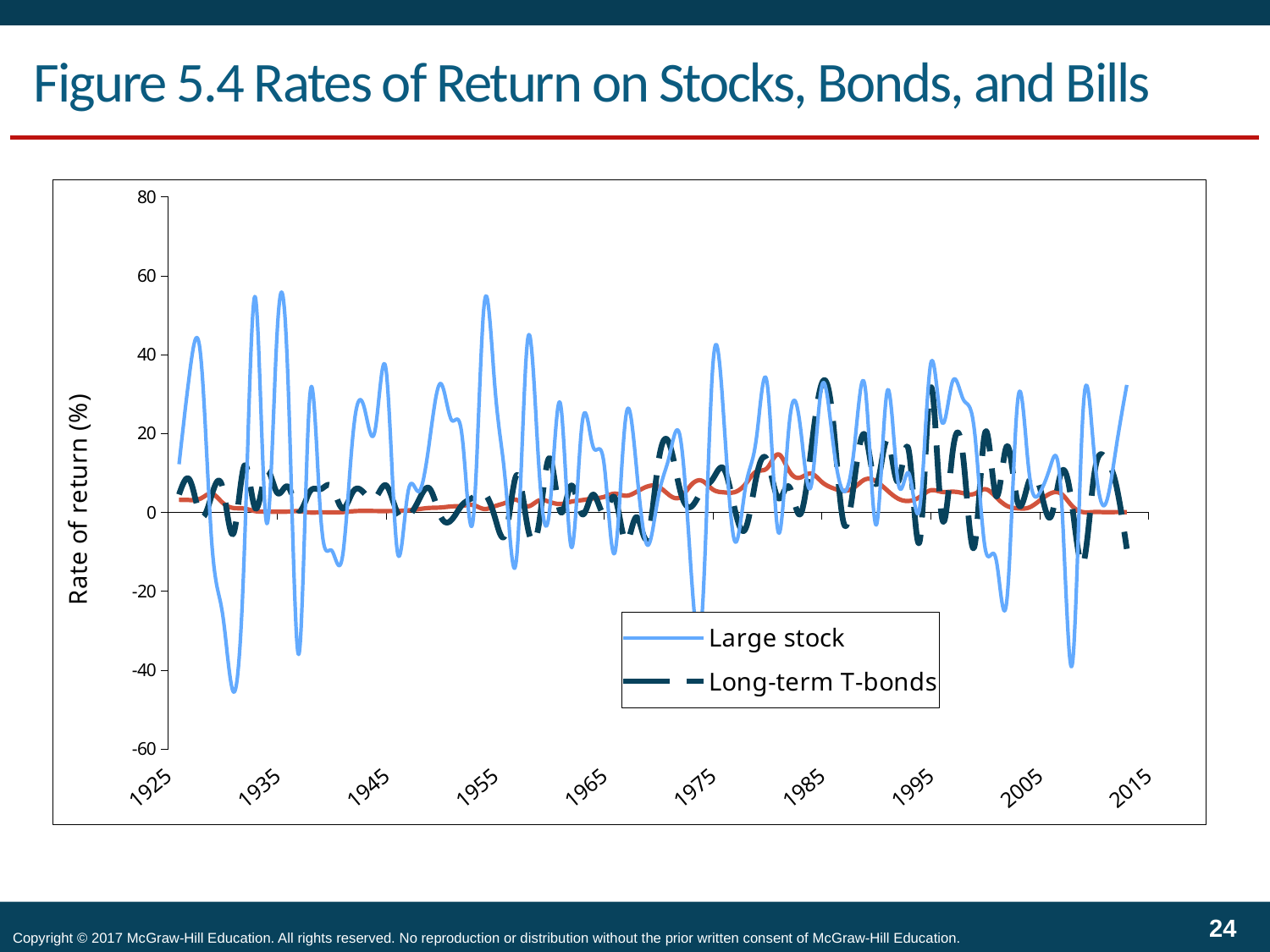
Which series reaches the lowest value on the chart? Large stock Is the highest value of the Long-term T-bonds series greater or less than 20? greater Which series shows larger swings from year to year, Large stock or Long-term T-bonds? Large stock Which series reaches the highest peak on the chart? Large stock How many year labels are shown on the horizontal axis? 10 What kind of chart is shown on the slide? line chart What is the title of the chart on the slide? Figure 5.4 Rates of Return on Stocks, Bonds, and Bills Is the highest value of the Long-term T-bonds series greater or less than 40? less Is the highest value of the Large stock series greater or less than 60? less What is the label of the vertical axis? Rate of return (%) What is the first year and the last year labelled on the horizontal axis? 1925 and 2015